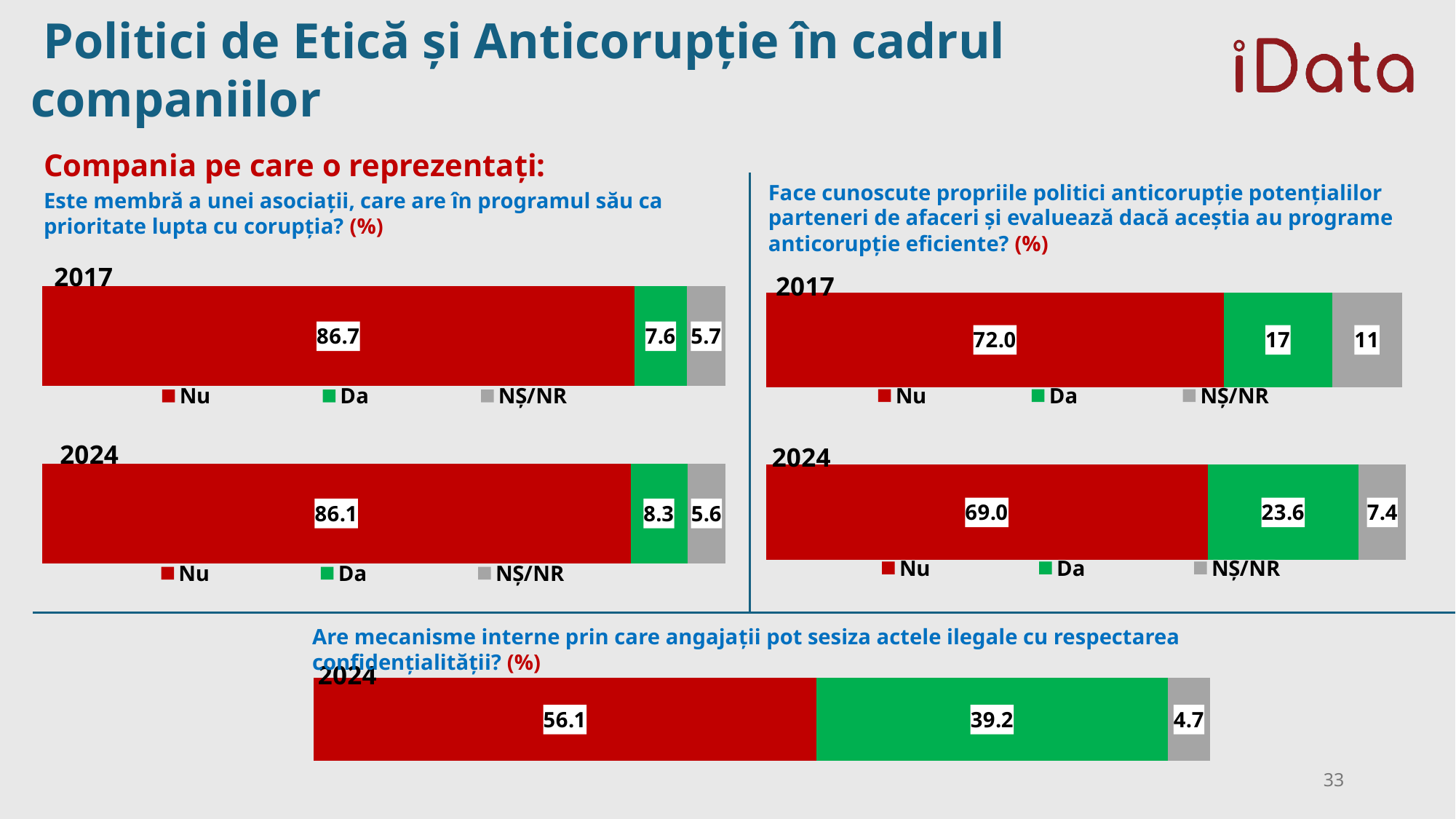
How many series does the legend list in the top-left chart? 3 In the top-right chart (making anticorruption policies known to partners), what is the value for "Da" in 2024? 23.6 In the bottom chart (internal mechanisms for employees to report illegal acts), what is the value for "Nu" in 2024? 56.1 In the top-right chart, what is the difference between the "Nu" values for 2017 and 2024? 3.0 In the top-left chart, what colour represents the "Da" series? Green In the top-left chart, which is larger in 2017: the value for "Da" or the value for "NȘ/NR"? Da What type of chart is used in the bottom chart (internal mechanisms for reporting illegal acts)? Stacked bar chart In the top-right chart (making anticorruption policies known to partners), what is the value for "NȘ/NR" in 2017? 11 In the top-left chart (membership in an association prioritising the fight against corruption), what is the value for "Nu" in 2017? 86.7 In the top-right chart, by how much did the "Da" value increase from 2017 to 2024? 6.6 In the top-left chart (membership in an association), what is the value for "Da" in 2024? 8.3 In the bottom chart (internal mechanisms for reporting illegal acts), which category has the lowest value? NȘ/NR